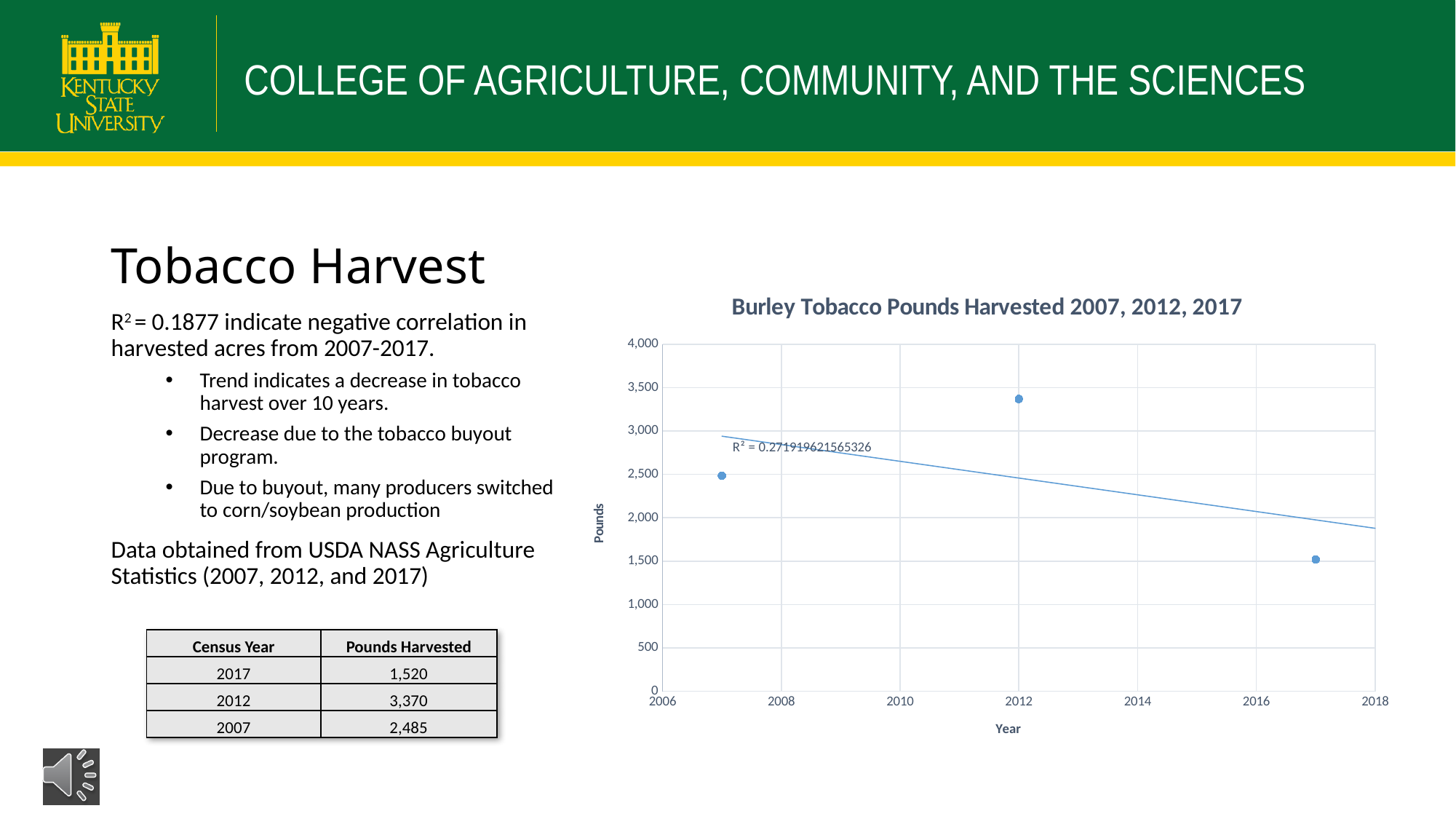
Which census year has the highest pounds harvested? 2012 Which census year has the lowest pounds harvested? 2017 Is the value plotted for 2012 greater or less than 3,000? greater What is the label on the vertical axis of the chart? Pounds What is the title of the chart? Burley Tobacco Pounds Harvested 2007, 2012, 2017 According to the slide, how many pounds were harvested in 2007? 2,485 What is the difference in pounds harvested between 2012 and 2017? 1,850 What kind of chart is shown on the slide? scatter chart According to the slide, how many pounds were harvested in 2012? 3,370 According to the slide, how many pounds were harvested in 2017? 1,520 How many data points are plotted on the chart? 3 Which year had more pounds harvested, 2007 or 2017? 2007